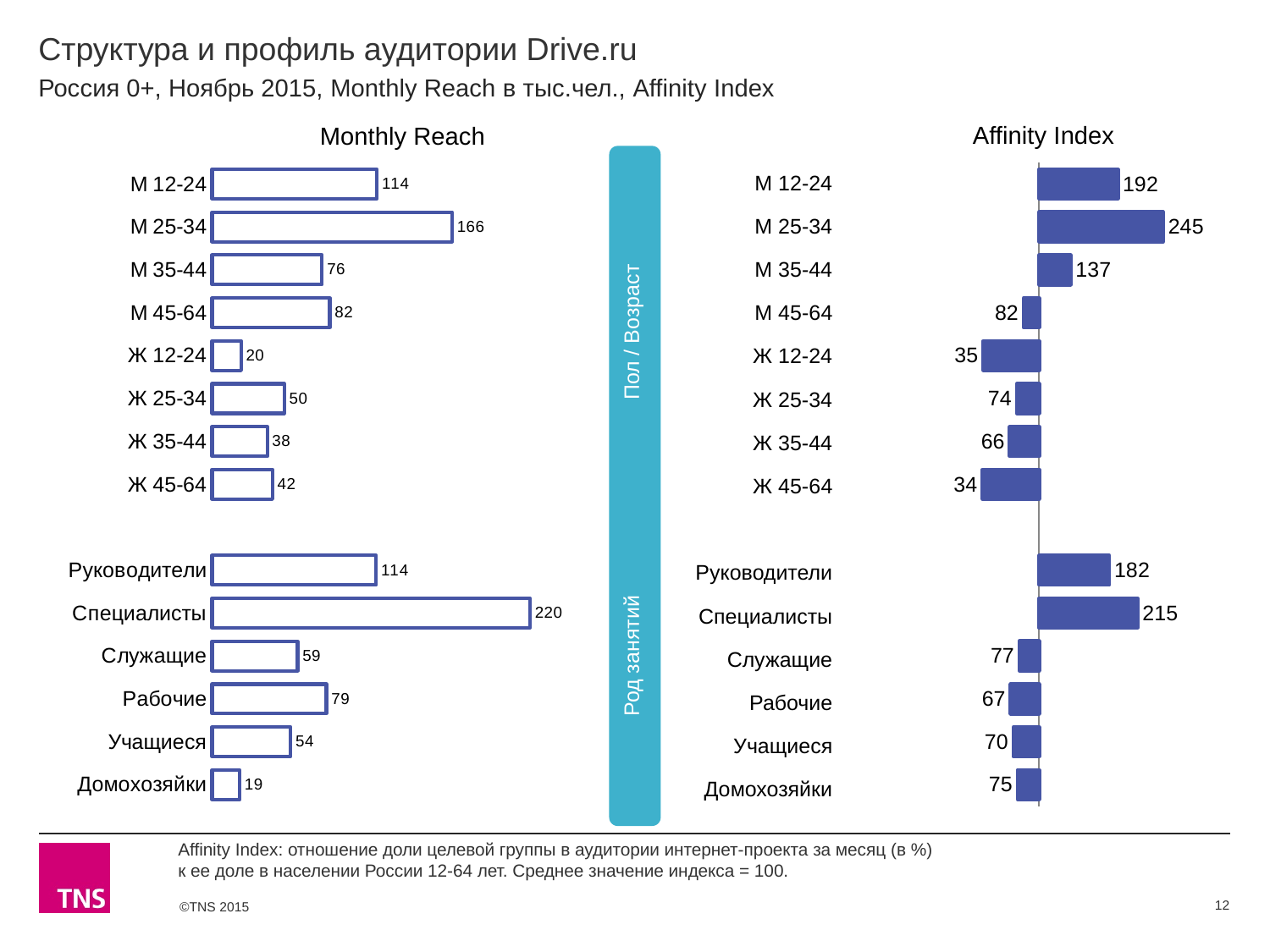
How many categories are plotted in the Monthly Reach chart? 14 In the Monthly Reach chart, which is larger: the value for Рабочие or the value for Служащие? Рабочие In the Affinity Index chart, what is the difference between the values for Специалисты and Руководители? 33 In the Monthly Reach chart, what is the value for М 25-34? 166 What kind of chart is the Affinity Index chart? Bar chart In the Affinity Index chart, which is larger: the value for М 35-44 or the value for М 45-64? М 35-44 In the Affinity Index chart, which category has the highest value? М 25-34 In the Affinity Index chart, what is the value for Специалисты? 215 In the Monthly Reach chart, which category has the highest value? Специалисты In the Affinity Index chart, which category has the lowest value? Ж 45-64 In the Monthly Reach chart, what is the difference between the values for М 25-34 and М 12-24? 52 In the Monthly Reach chart, which category has the lowest value? Домохозяйки